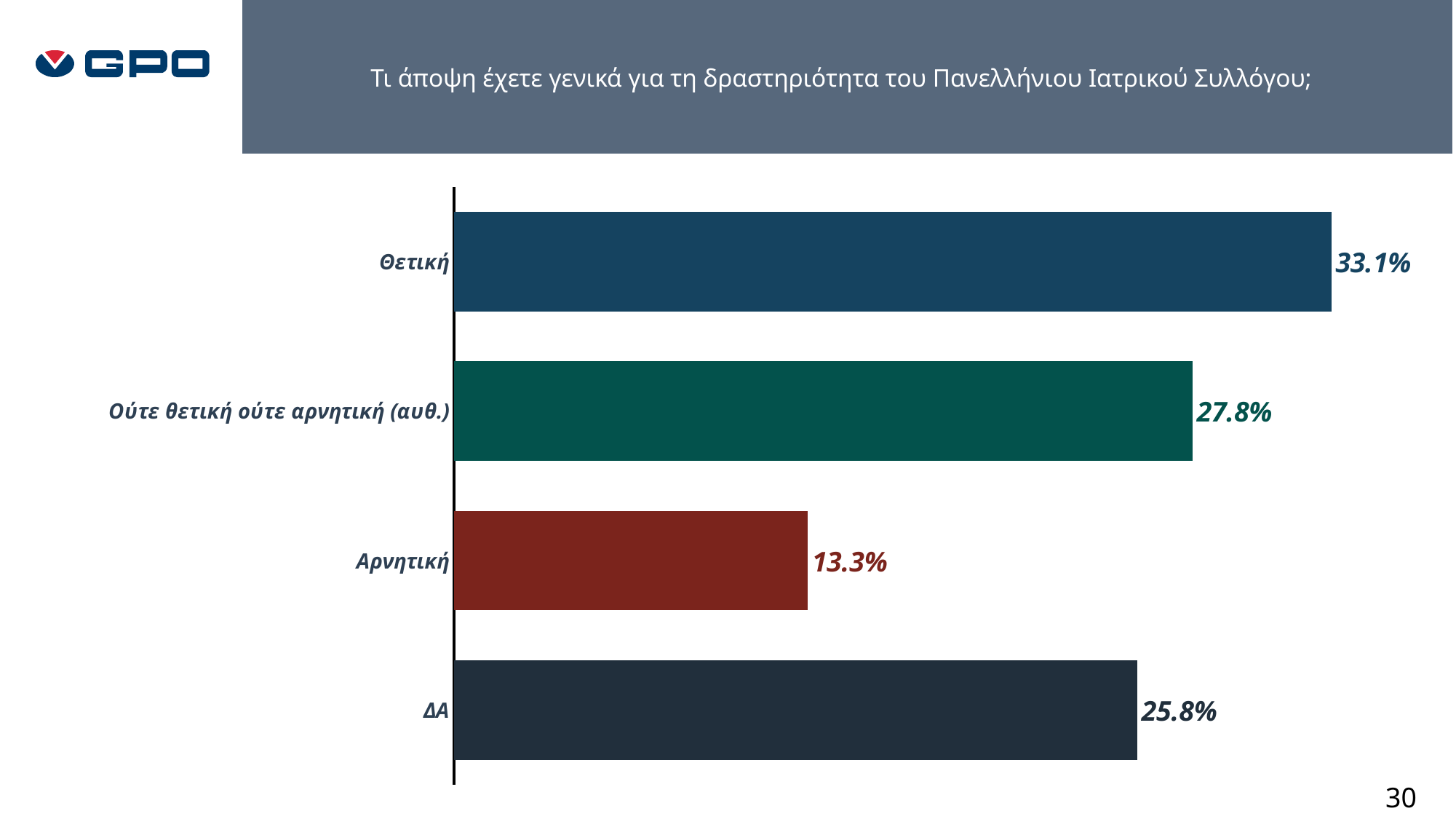
How many categories are shown in the chart? 4 What colour is the bar for Αρνητική? dark red Which is larger, the value for ΔΑ or the value for Αρνητική? ΔΑ What is the difference between the values for Ούτε θετική ούτε αρνητική (αυθ.) and ΔΑ? 2.0% What is the value for Αρνητική? 13.3% Which category has the highest value? Θετική What kind of chart is shown on the slide? bar chart What is the value for ΔΑ? 25.8% What is the value for Ούτε θετική ούτε αρνητική (αυθ.)? 27.8% Which category has the lowest value? Αρνητική What is the value for Θετική? 33.1% What is the difference between the values for Θετική and Αρνητική? 19.8%